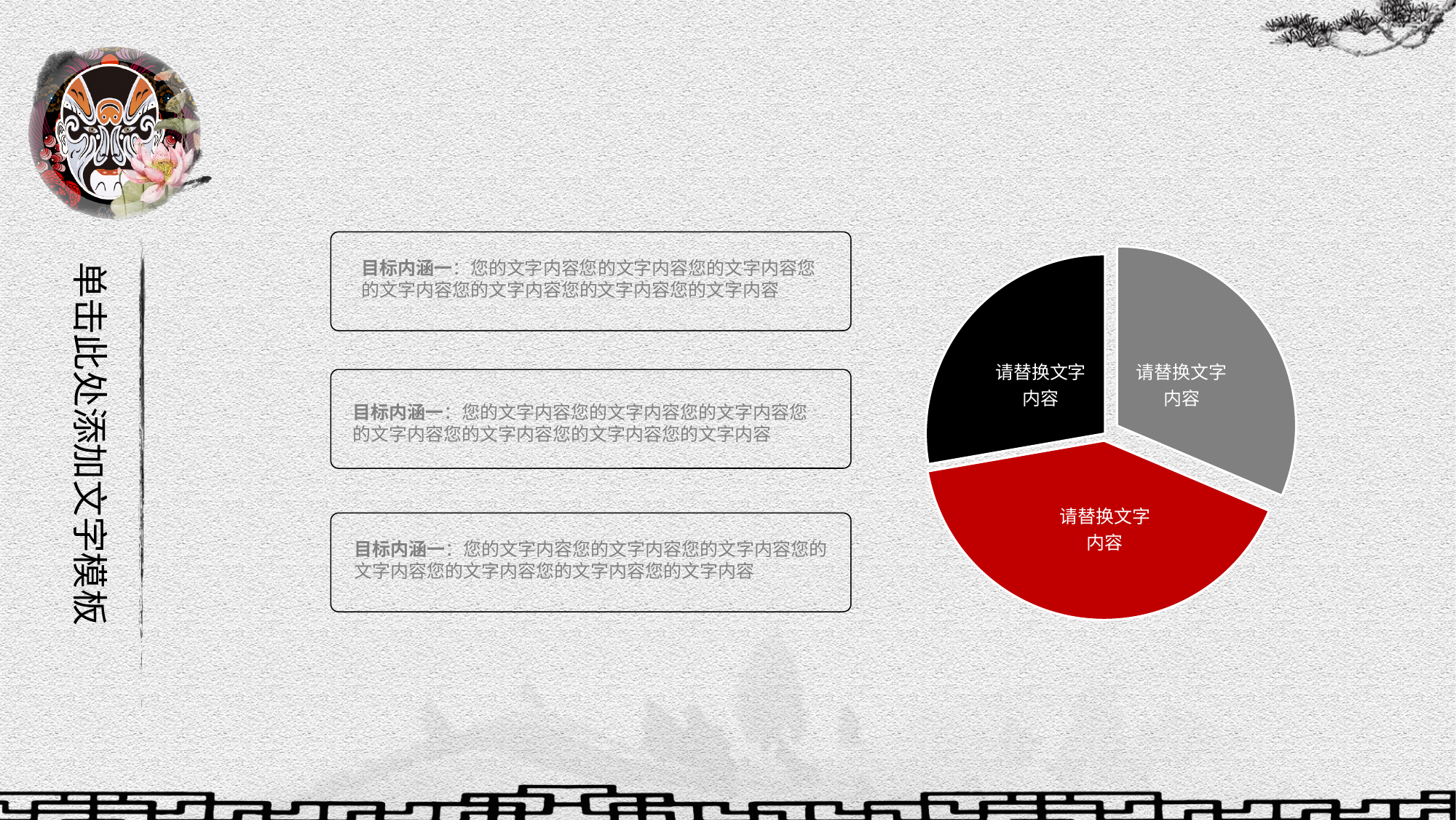
Which slice of the pie chart is the largest? the red slice Is the red slice of the pie chart larger or smaller than the black slice? larger What kind of chart is shown on the slide? pie chart Does the pie chart show a legend? no How many slices does the pie chart have? 3 What text is shown as the label on each slice of the pie chart? 请替换文字内容 What colours are the three slices of the pie chart? black, gray and red Is the red slice of the pie chart larger or smaller than the gray slice? larger